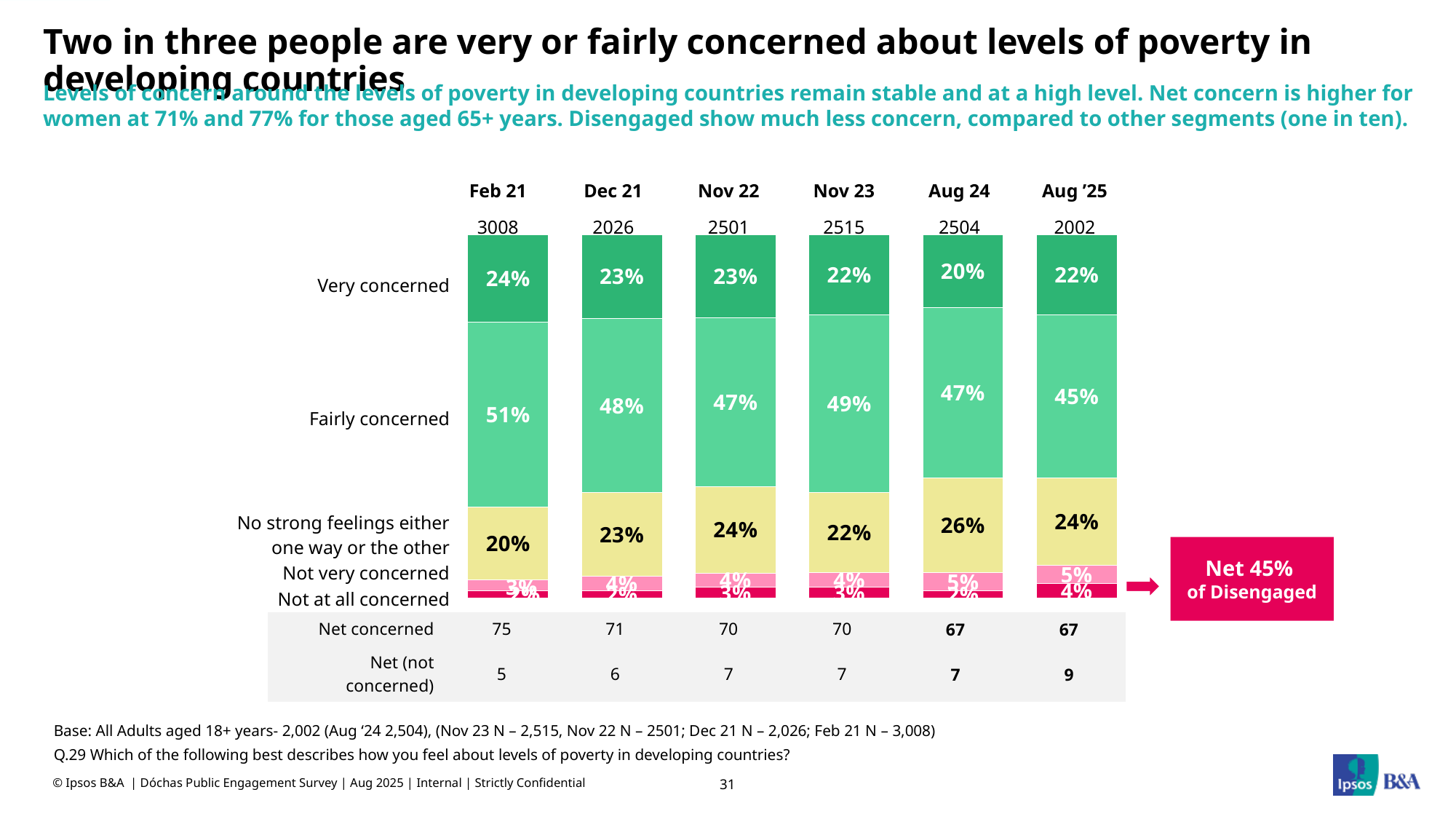
Which wave had a larger share with no strong feelings either one way or the other, Nov 22 or Nov 23? Nov 22 How many response categories are stacked in each bar? 5 What percentage of respondents were not very concerned in Aug '25? 5% Does the fairly concerned share generally rise or fall from Feb 21 to Aug '25? Fall How many survey waves are shown in the chart? 6 In which wave was the very concerned share lowest? Aug 24 What type of chart is shown on the slide? Stacked bar chart What percentage of respondents were fairly concerned in Aug '25? 45% What percentage of respondents were very concerned in Feb 21? 24% By how many percentage points did the fairly concerned share fall from Feb 21 to Aug '25? 6 percentage points What percentage had no strong feelings either one way or the other in Aug 24? 26% In which wave was the fairly concerned share highest? Feb 21